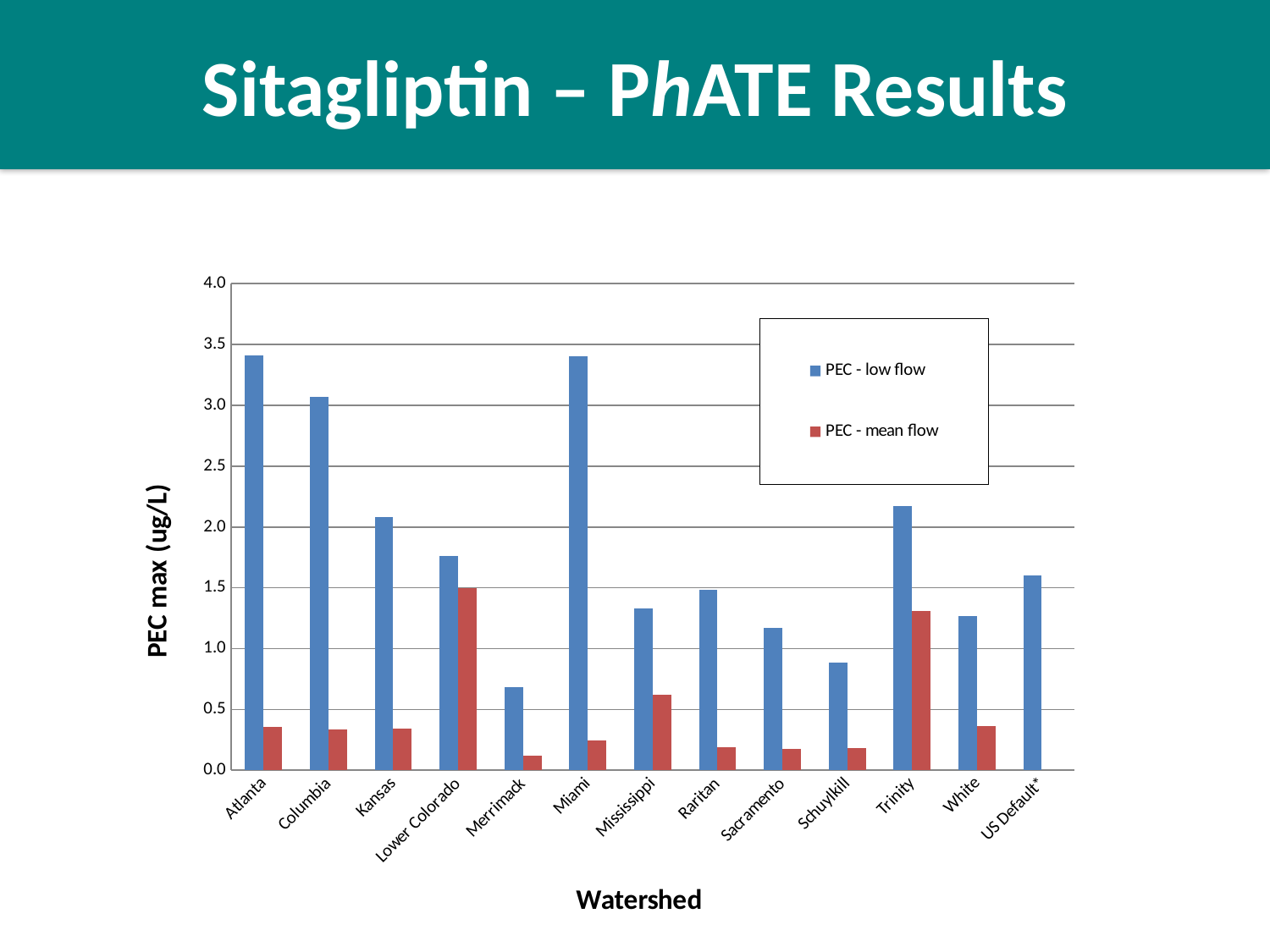
Which has the larger PEC - low flow value, Raritan or Sacramento? Raritan Is the PEC - mean flow value for Mississippi greater or less than 0.5? greater How many watersheds are shown on the x axis? 13 Is the PEC - low flow value for Trinity greater or less than 2.0? greater Is the PEC - low flow value for Schuylkill greater or less than 1.0? less Which watershed has the highest PEC - mean flow value? Lower Colorado Which has the larger PEC - mean flow value, Lower Colorado or Trinity? Lower Colorado What is the title of the y axis? PEC max (ug/L) What kind of chart is shown on the slide? bar chart How many series does the legend list? 2 Which watershed has the lowest PEC - low flow value? Merrimack